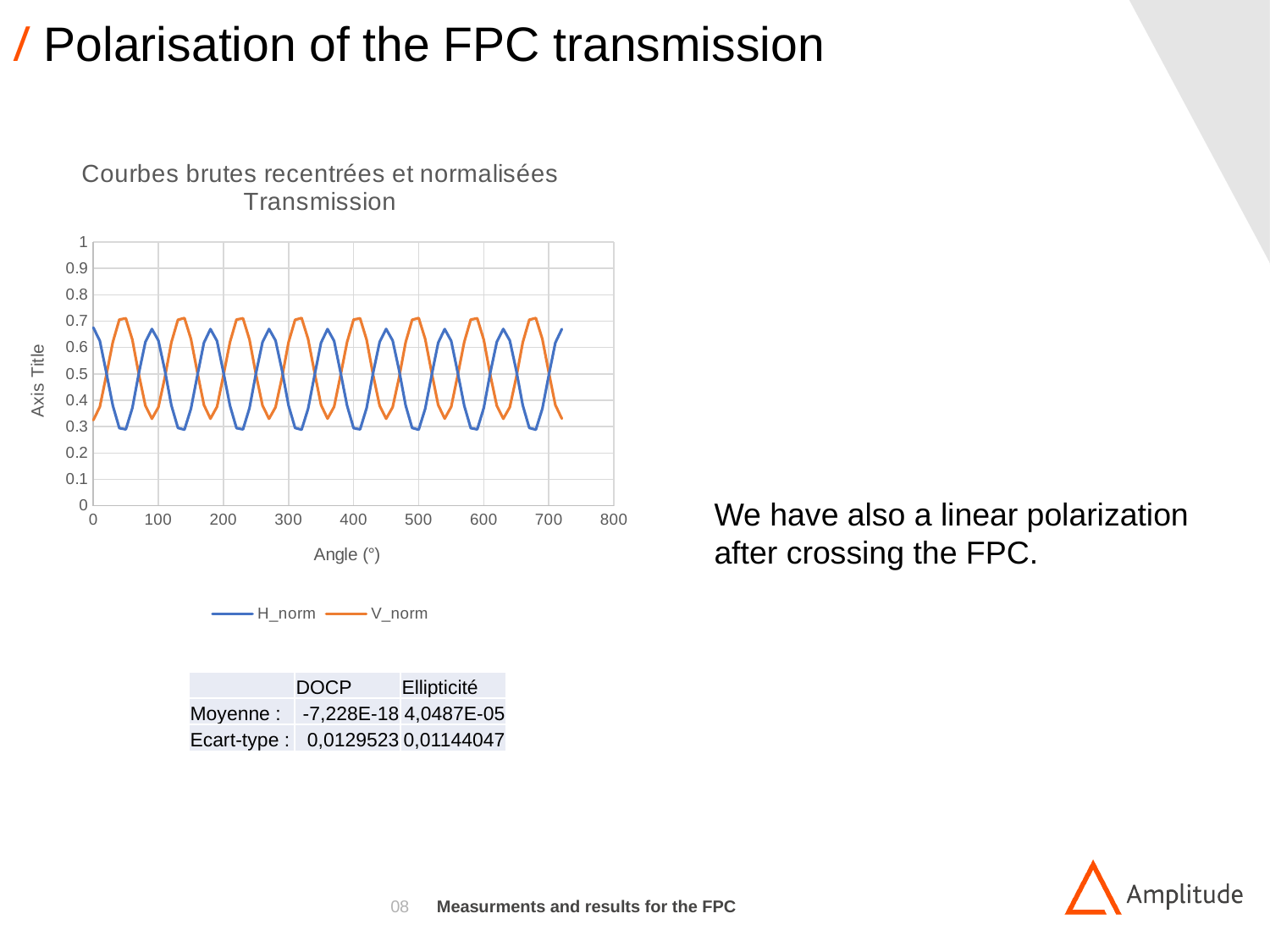
How many series does the chart legend list? 2 What is the label of the x axis of the chart? Angle (°) Is the highest value reached by the V_norm series greater or less than 0.8? less What are the names of the two series in the chart legend? H_norm and V_norm Is the lowest value reached by the H_norm series greater or less than 0.2? greater Which series reaches the lower minimum value, H_norm or V_norm? H_norm What kind of chart is shown on the slide? line chart Is the value of V_norm at an angle of 0° greater or less than 0.5? less What is the maximum value shown on the y axis of the chart? 1